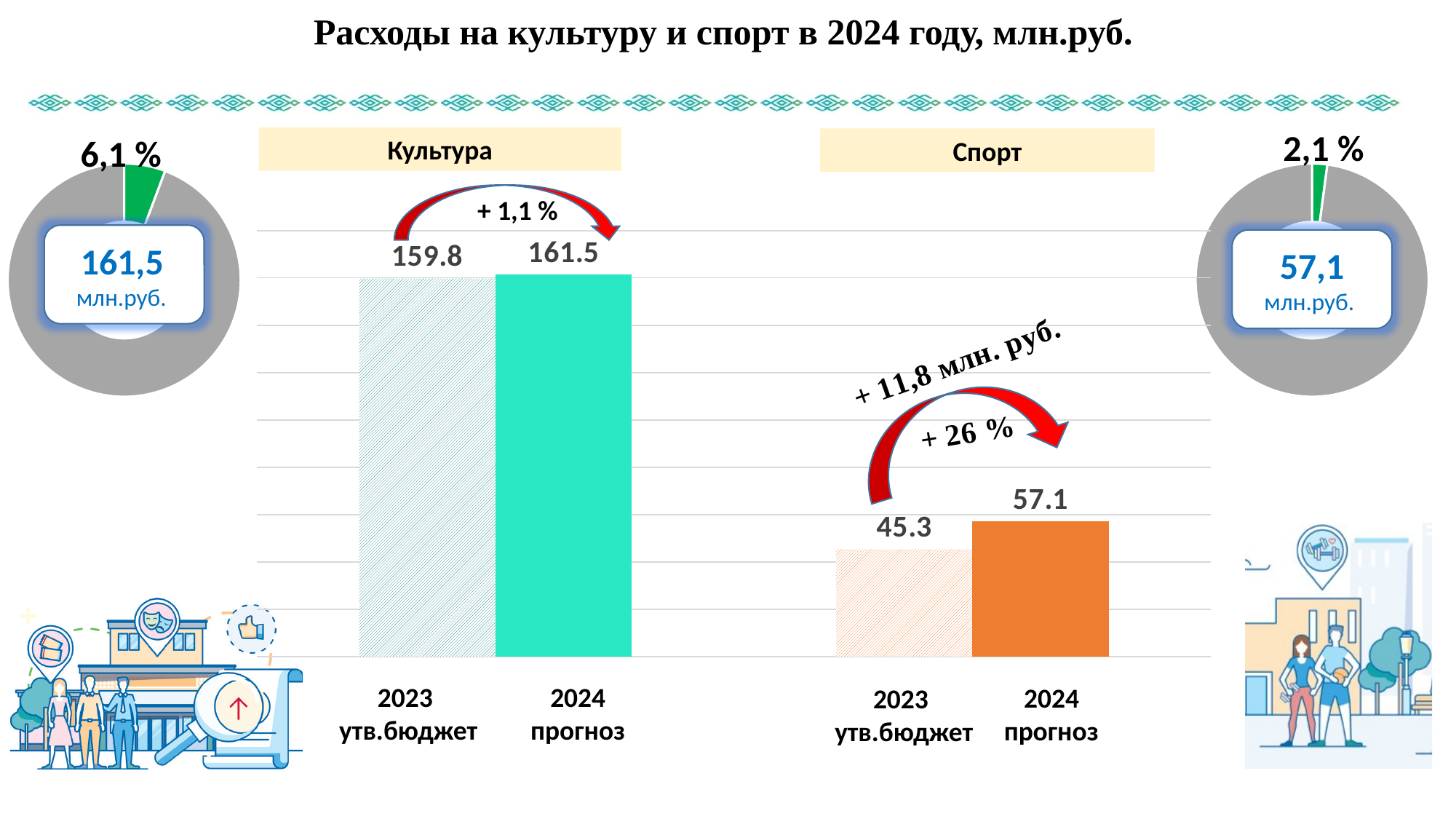
What percentage share does the donut chart next to the Культура chart show? 6,1 % In the Спорт chart, what is the difference between the 2024 прогноз and 2023 утв.бюджет values? 11.8 In the Спорт chart, what is the value for 2023 утв.бюджет? 45.3 How many bars are in the Спорт chart? 2 In the Спорт chart, what is the value for 2024 прогноз? 57.1 In the Спорт chart, which is larger: 2023 утв.бюджет or 2024 прогноз? 2024 прогноз In the Культура chart, what is the difference between the 2024 прогноз and 2023 утв.бюджет values? 1.7 In the Культура chart, what is the value for 2023 утв.бюджет? 159.8 What percentage share does the donut chart next to the Спорт chart show? 2,1 % What kind of chart is the Культура chart? bar chart In the Спорт chart, do the values rise or fall from 2023 to 2024? rise In the Культура chart, what is the value for 2024 прогноз? 161.5